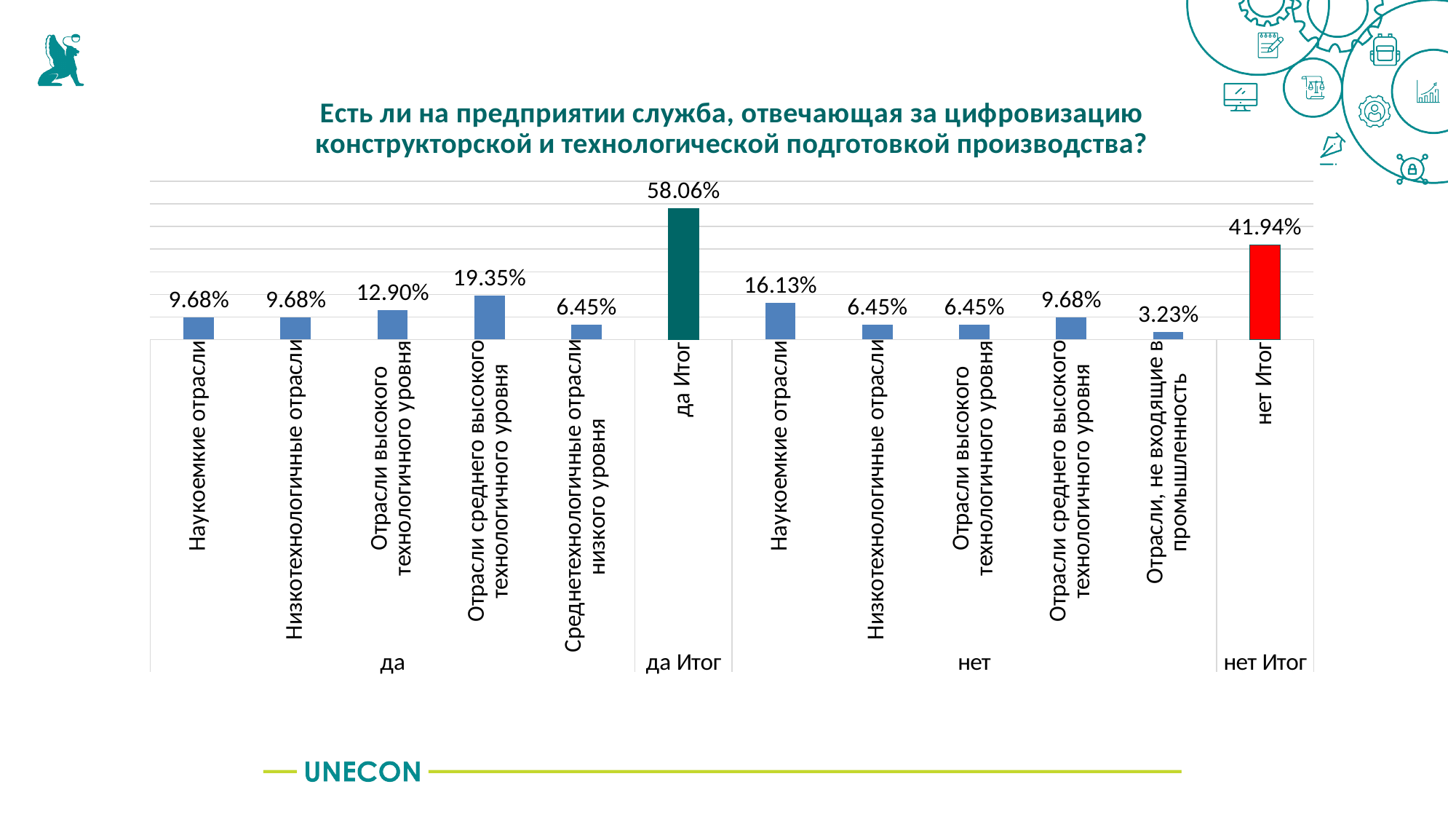
Which is larger: "Наукоемкие отрасли" in the "да" group or "Наукоемкие отрасли" in the "нет" group? Наукоемкие отрасли in the нет group What is the value for "да Итог"? 58.06% In the "нет" group, what is the value for "Отрасли, не входящие в промышленность"? 3.23% What kind of chart is shown on the slide? bar chart What is the value for "нет Итог"? 41.94% Which bar has the highest value in the chart? да Итог How many bars are plotted in the chart? 12 What is the difference between "да Итог" and "нет Итог"? 16.12% What colour is the "нет Итог" bar? red Which bar has the lowest value in the chart? Отрасли, не входящие в промышленность In the "нет" group, what is the value for "Наукоемкие отрасли"? 16.13% In the "да" group, what is the value for "Отрасли среднего высокого технологичного уровня"? 19.35%